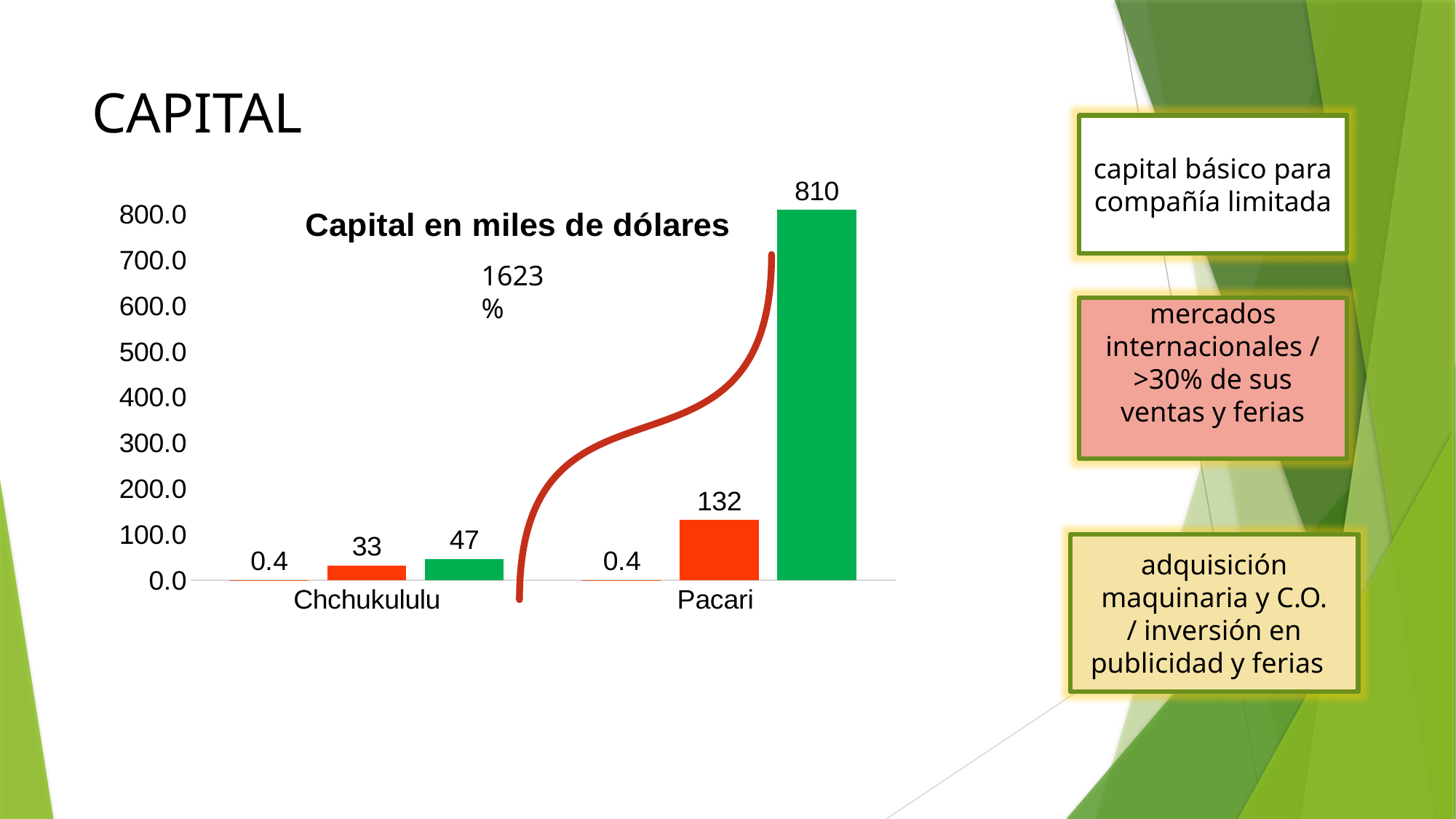
What is the value of the green bar for Pacari? 810 Which bar in the chart has the highest value? the green bar for Pacari (810) Which is larger, the red bar for Pacari or the green bar for Chchukululu? the red bar for Pacari What is the value of the green bar for Chchukululu? 47 What is the value of the first (leftmost) bar for Pacari? 0.4 What kind of chart is shown on the slide? bar chart What is the value of the red bar for Chchukululu? 33 What is the title of the chart? Capital en miles de dólares What is the value of the red bar for Pacari? 132 What percentage is written next to the red arrow in the chart? 1623 % What is the difference between the green bar for Pacari and the green bar for Chchukululu? 763 How many categories are shown on the x axis of the chart? 2